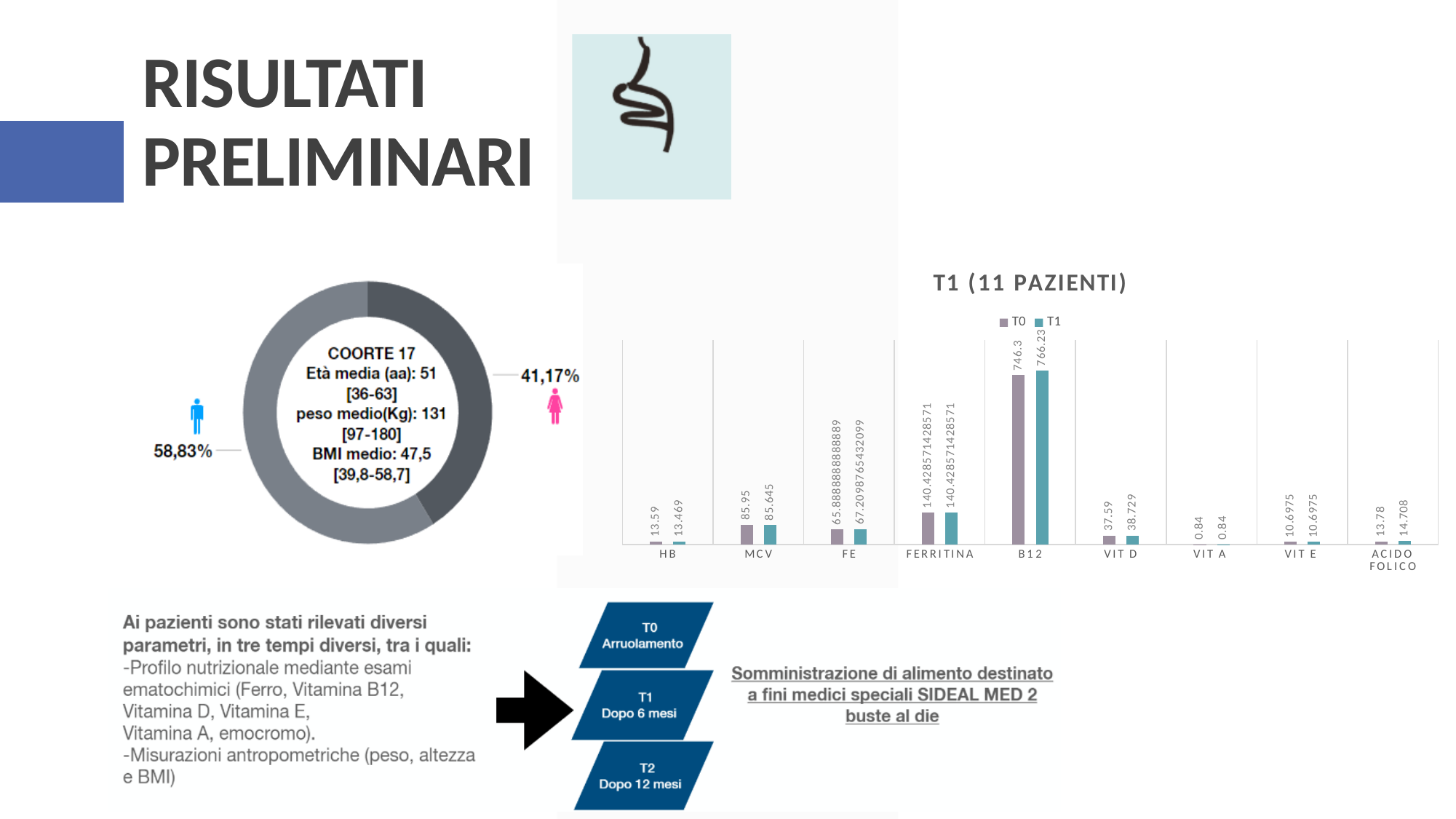
In the bar chart titled 'T1 (11 PAZIENTI)', how many series does the legend list? 2 In the bar chart titled 'T1 (11 PAZIENTI)', what is the T1 value for B12? 766.23 In the bar chart titled 'T1 (11 PAZIENTI)', what is the difference between the T1 and T0 values for B12? 19.93 In the bar chart titled 'T1 (11 PAZIENTI)', how many categories are shown on the x axis? 9 In the bar chart titled 'T1 (11 PAZIENTI)', what is the T0 value for HB? 13.59 In the bar chart titled 'T1 (11 PAZIENTI)', which category has the highest values? B12 In the bar chart titled 'T1 (11 PAZIENTI)', what is the T1 value for VIT D? 38.729 In the bar chart titled 'T1 (11 PAZIENTI)', which category has the lowest values? VIT A In the donut chart on the left, what percentage is shown for the male share of the cohort? 58,83% In the donut chart on the left, what percentage is shown for the female share of the cohort? 41,17% In the bar chart titled 'T1 (11 PAZIENTI)', what is the T1 value for ACIDO FOLICO? 14.708 In the bar chart titled 'T1 (11 PAZIENTI)', what is the T0 value for B12? 746.3